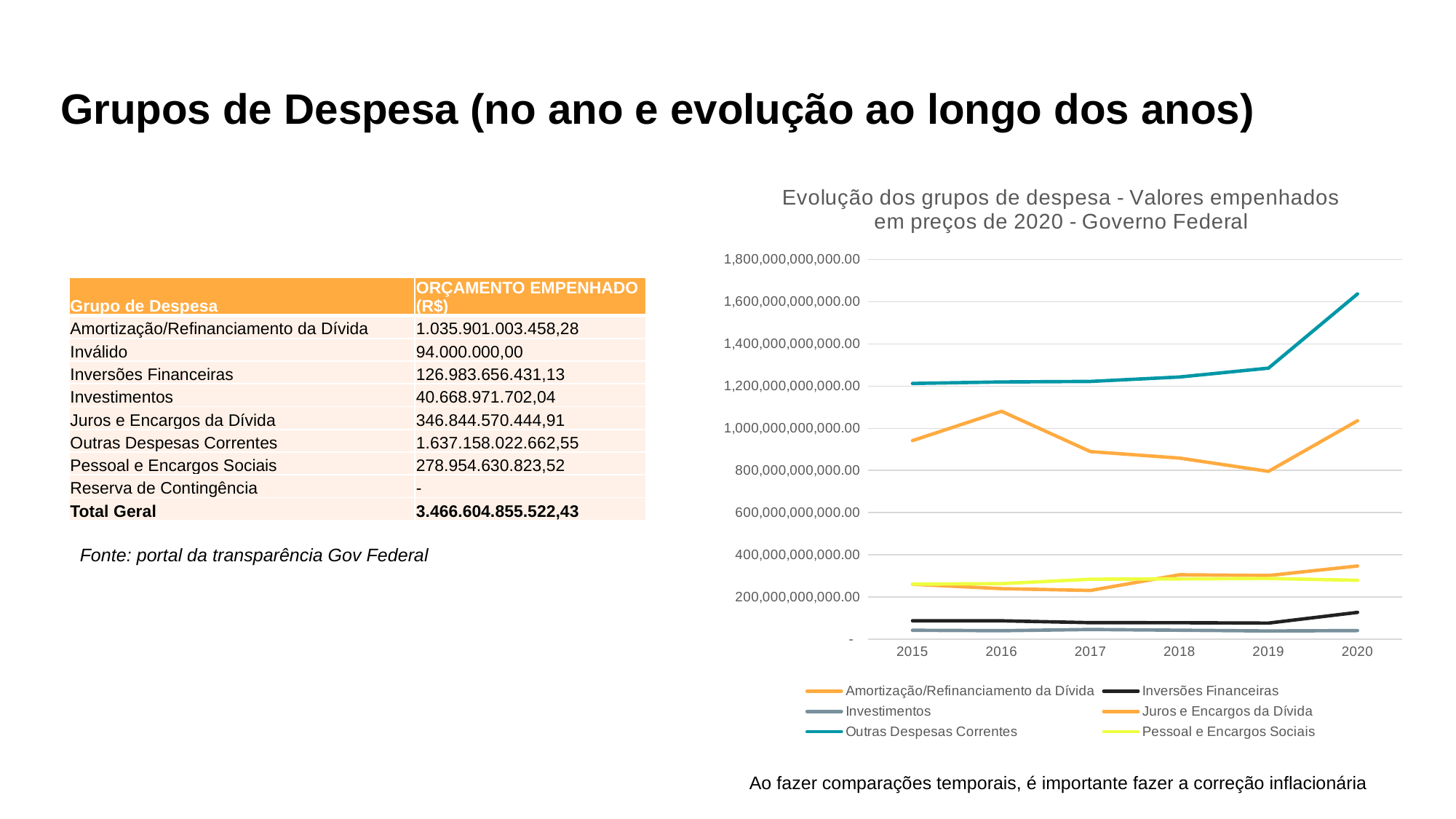
Is the value for Outras Despesas Correntes in 2020 greater or less than 1,400,000,000,000.00? greater Is the value for Amortização/Refinanciamento da Dívida in 2017 greater or less than 1,000,000,000,000.00? less Does the Outras Despesas Correntes line rise or fall from 2015 to 2020? rise How many years are shown on the x axis of the chart? 6 In which year does Amortização/Refinanciamento da Dívida reach its lowest value? 2019 What kind of chart is shown on the slide? line chart In which year does Outras Despesas Correntes reach its highest value? 2020 Which series has the lowest values across all years in the chart? Investimentos Which series has the highest values across all years in the chart? Outras Despesas Correntes In 2016, which is larger: Amortização/Refinanciamento da Dívida or Juros e Encargos da Dívida? Amortização/Refinanciamento da Dívida Is the value for Inversões Financeiras in 2020 greater or less than 200,000,000,000.00? less How many series does the chart legend list? 6